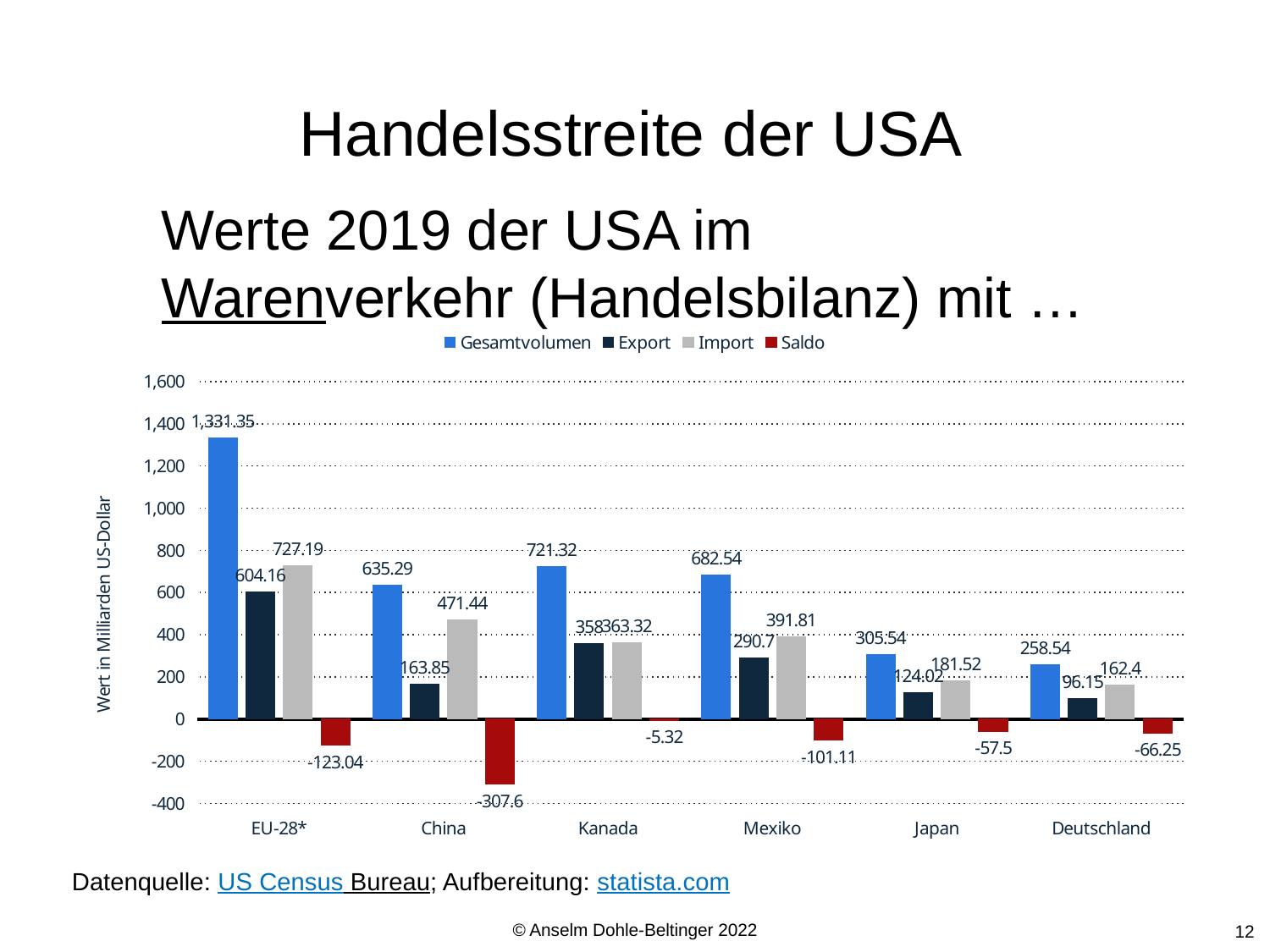
What kind of chart is shown on the slide? bar chart What is the Import value for China? 471.44 How many series does the legend list? 4 What is the Saldo value for China? -307.6 What is the difference between the Import and Export values for Mexiko? 101.11 What is the Saldo value for Kanada? -5.32 What is the label of the vertical axis? Wert in Milliarden US-Dollar Which trading partner has the lowest (most negative) Saldo? China What is the Gesamtvolumen value for EU-28*? 1,331.35 How many trading partners (categories) are shown on the x axis? 6 Which is larger, the Import value for Japan or the Import value for Deutschland? Japan Which trading partner has the highest Gesamtvolumen? EU-28*